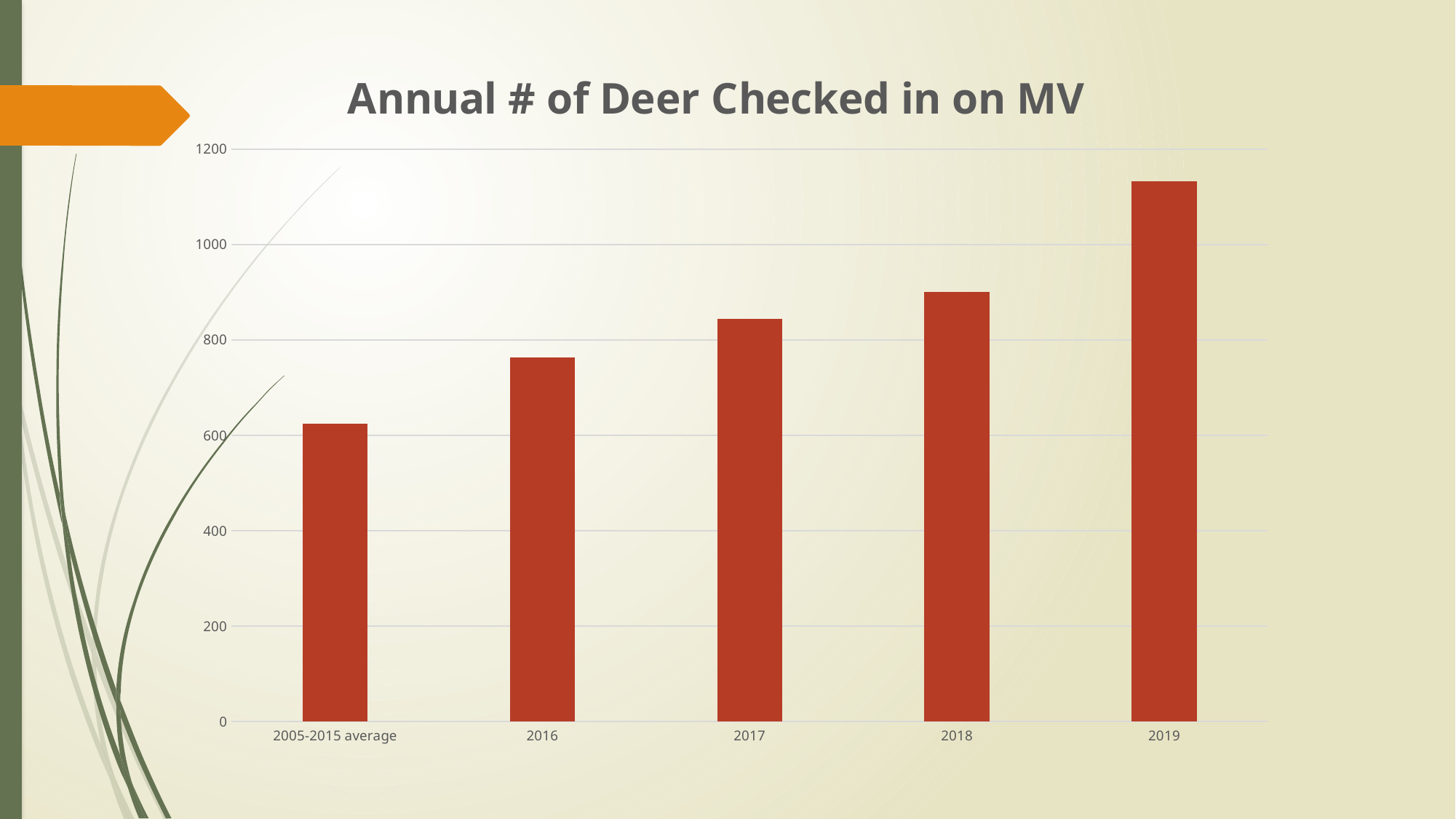
Is the value for 2016 greater or less than 800? less Do the values rise or fall from left to right along the x axis? rise Is the value for 2018 greater or less than 1000? less Is the value for 2017 greater or less than 800? greater Which category has the highest number of deer checked in? 2019 How many categories are shown on the x axis? 5 What kind of chart is shown on the slide? bar chart Which category has the lowest number of deer checked in? 2005-2015 average Which is larger, the value for 2017 or the value for 2019? 2019 What is the title of the chart? Annual # of Deer Checked in on MV